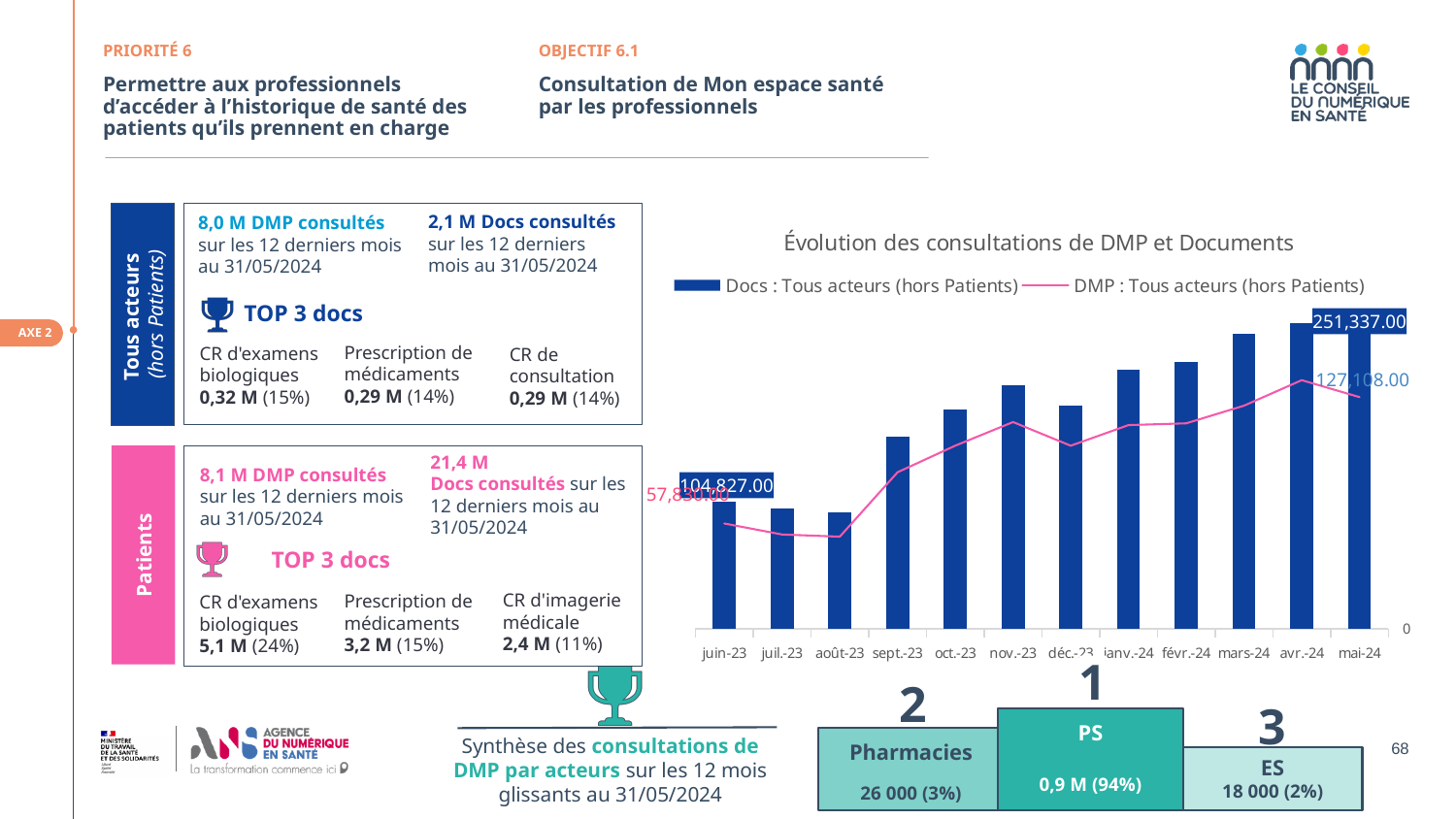
Which month has the higher 'Docs : Tous acteurs (hors Patients)' bar, nov.-23 or déc.-23? nov.-23 How many months are shown on the x axis of the chart? 12 Do the 'Docs : Tous acteurs (hors Patients)' bars generally rise or fall from juin-23 to mai-24? rise In mai-24, what is the difference between the Docs value and the DMP value? 124,229.00 What kind of chart is used for 'Évolution des consultations de DMP et Documents'? bar chart with a line What is the value of 'Docs : Tous acteurs (hors Patients)' for juin-23? 104,827.00 What is the title of the chart on the slide? Évolution des consultations de DMP et Documents What is the value of 'DMP : Tous acteurs (hors Patients)' for mai-24? 127,108.00 By how much did 'Docs : Tous acteurs (hors Patients)' increase from juin-23 to mai-24? 146,510.00 How many series does the legend of the chart list? 2 What is the value of 'Docs : Tous acteurs (hors Patients)' for mai-24? 251,337.00